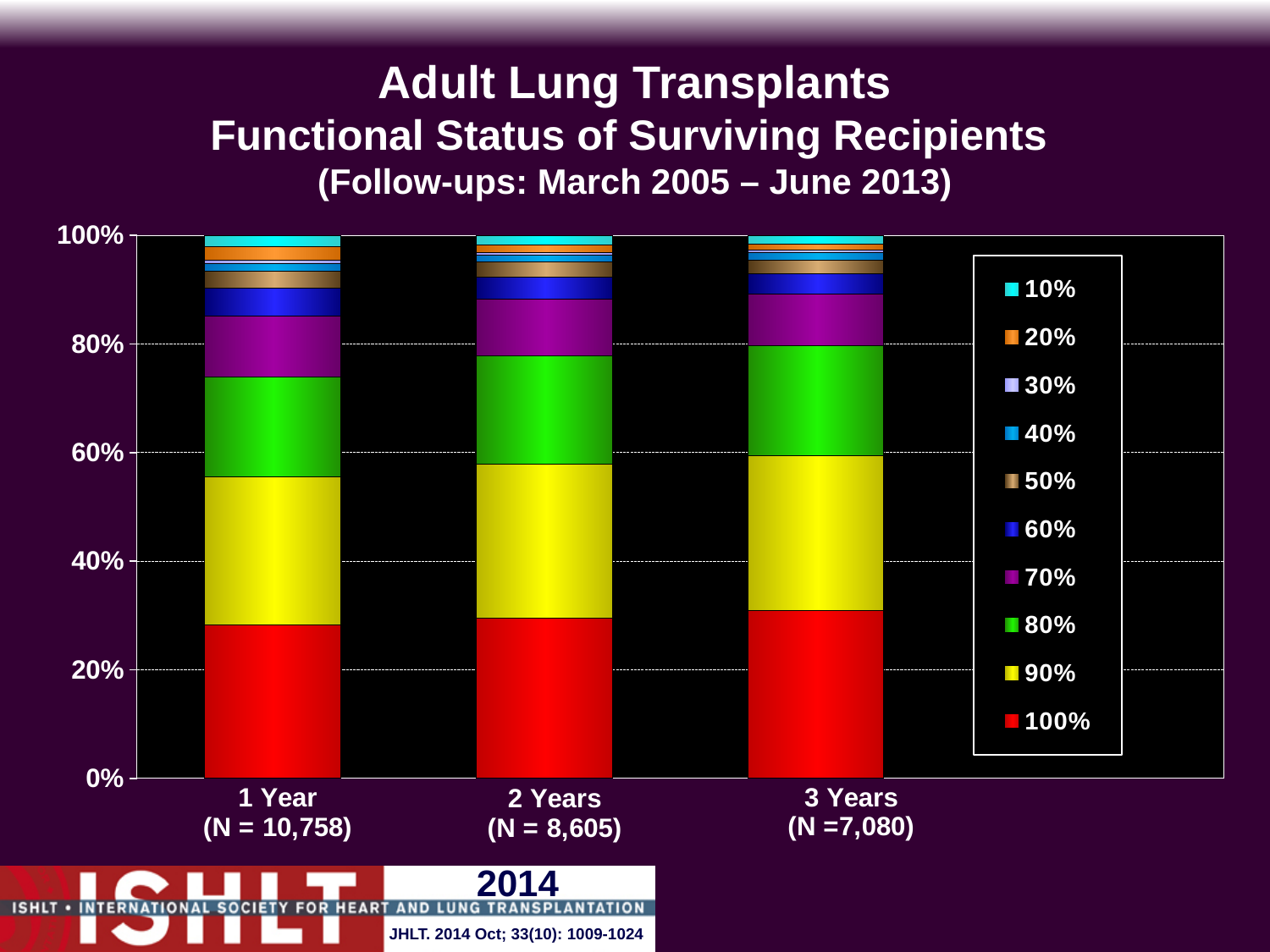
What does each stacked bar total? 100% Is the 100% functional status segment larger at 1 Year or at 3 Years? 3 Years How many follow-up time points (bars) are shown on the x axis? 3 What colour represents the 100% functional status series in the legend? red What is the N for the 1 Year follow-up? N = 10,758 Does the 100% functional status segment rise or fall from 1 Year to 3 Years? rises Is the combined share of recipients with 90% or 100% functional status at 1 Year greater or less than 60%? less How many series does the legend list? 10 Is the share of recipients with 100% functional status at 2 Years greater or less than 20%? greater What kind of chart is shown on the slide? stacked bar chart Is the share of recipients with 100% functional status at 1 Year greater or less than 40%? less